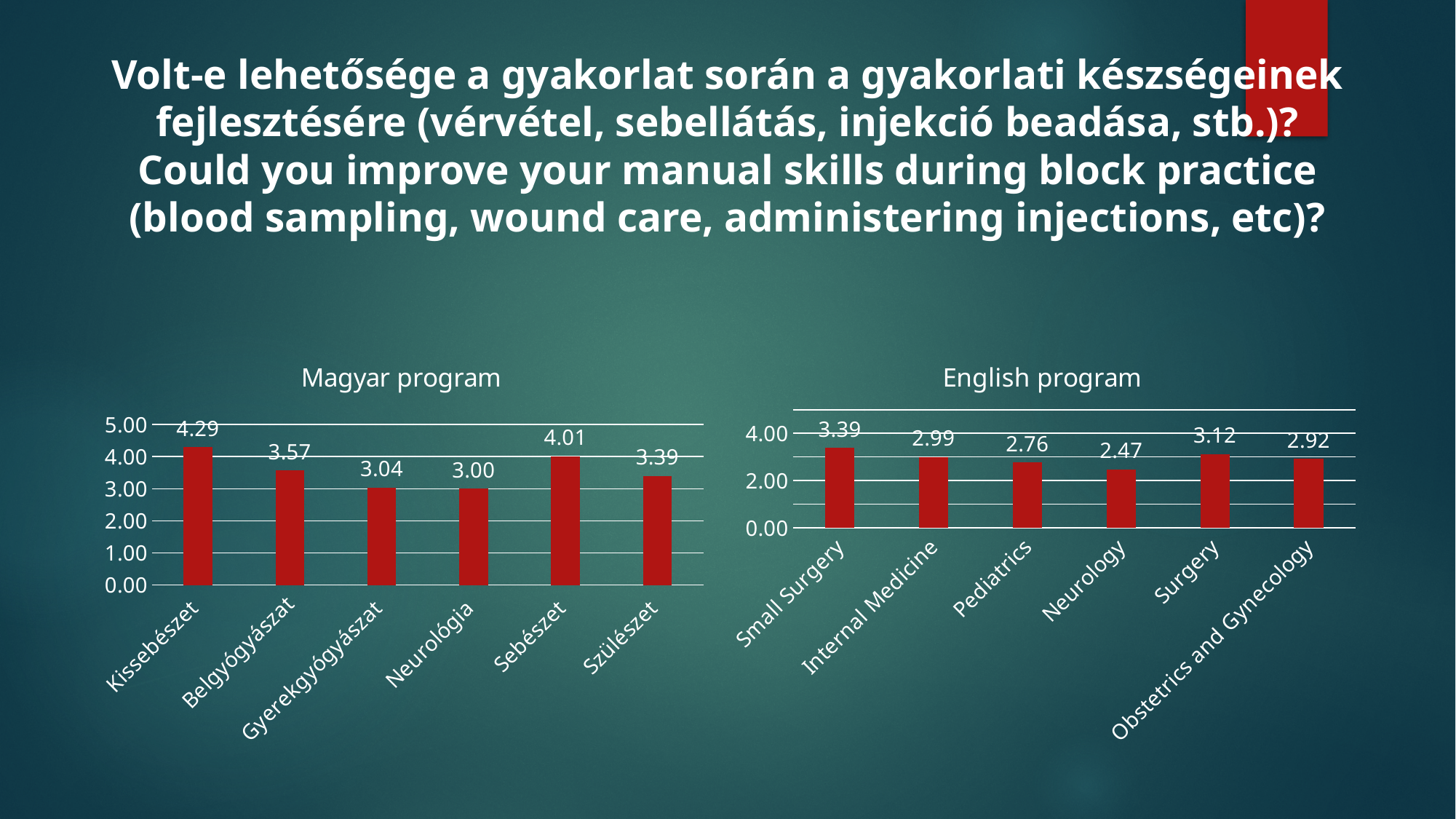
In the English program chart, which category has the lowest value? Neurology In the Magyar program chart, which category has the highest value? Kissebészet In the Magyar program chart, what is the value for Neurológia? 3.00 In the English program chart, which category has the highest value? Small Surgery In the English program chart, what is the value for Neurology? 2.47 In the Magyar program chart, how many categories are shown? 6 In the English program chart, which is larger, Internal Medicine or Pediatrics? Internal Medicine What kind of chart is the English program chart? Bar chart In the Magyar program chart, which category has the lowest value? Neurológia In the Magyar program chart, what is the difference between Kissebészet and Szülészet? 0.90 In the English program chart, what is the value for Obstetrics and Gynecology? 2.92 In the Magyar program chart, what is the value for Kissebészet? 4.29